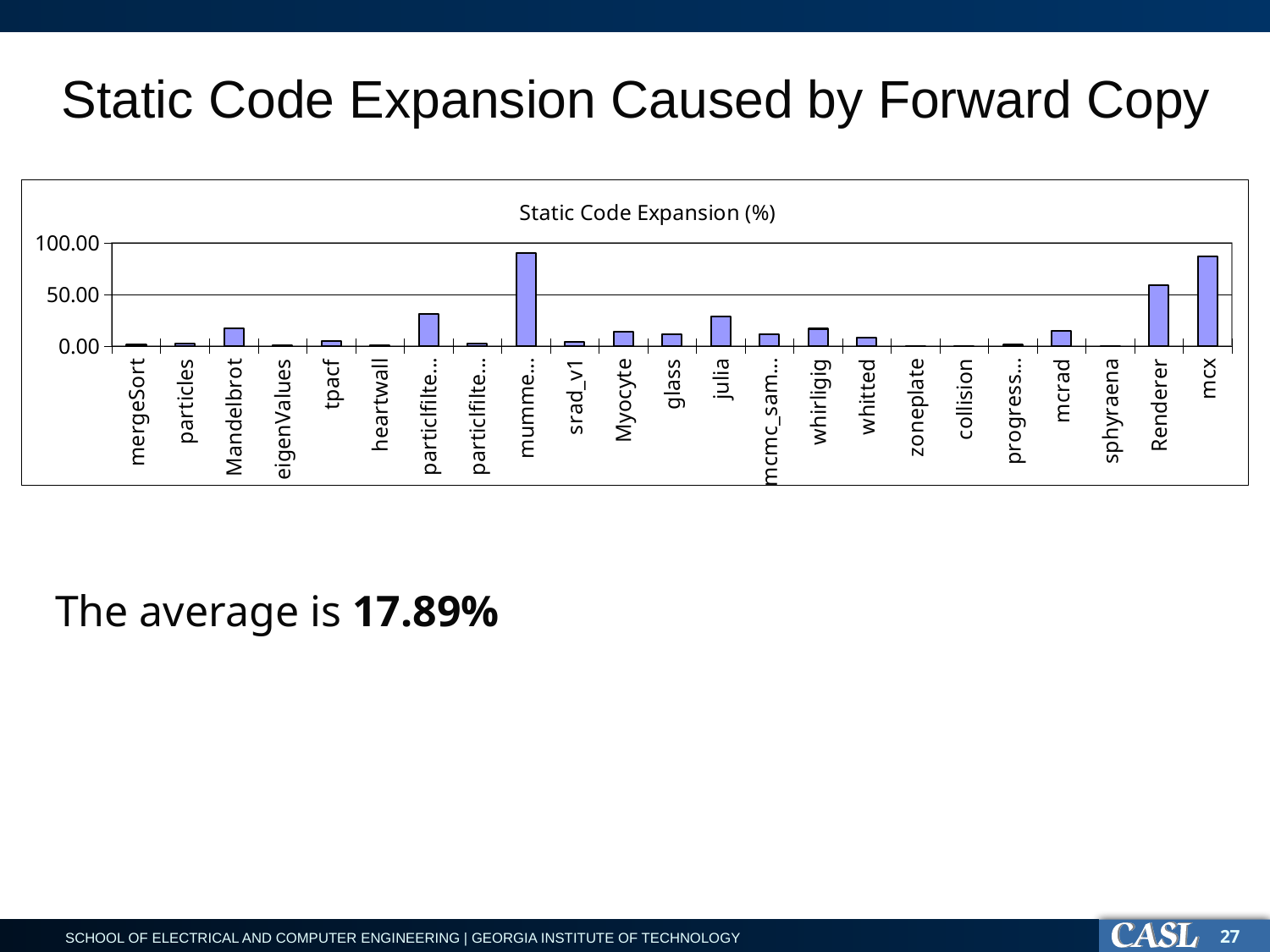
Is the value for julia greater or less than 50.00? less Is the value for Mandelbrot greater or less than 50.00? less What kind of chart is shown on the slide? bar chart Which has the larger value, Renderer or Mandelbrot? Renderer How many categories (benchmarks) are plotted on the x axis of the chart? 23 Is the value for whitted greater or less than 50.00? less According to the text on the slide, what is the average static code expansion? 17.89% What is the title of the chart? Static Code Expansion (%) Which has the larger value, mcx or whirligig? mcx Which has the larger value, julia or Myocyte? julia